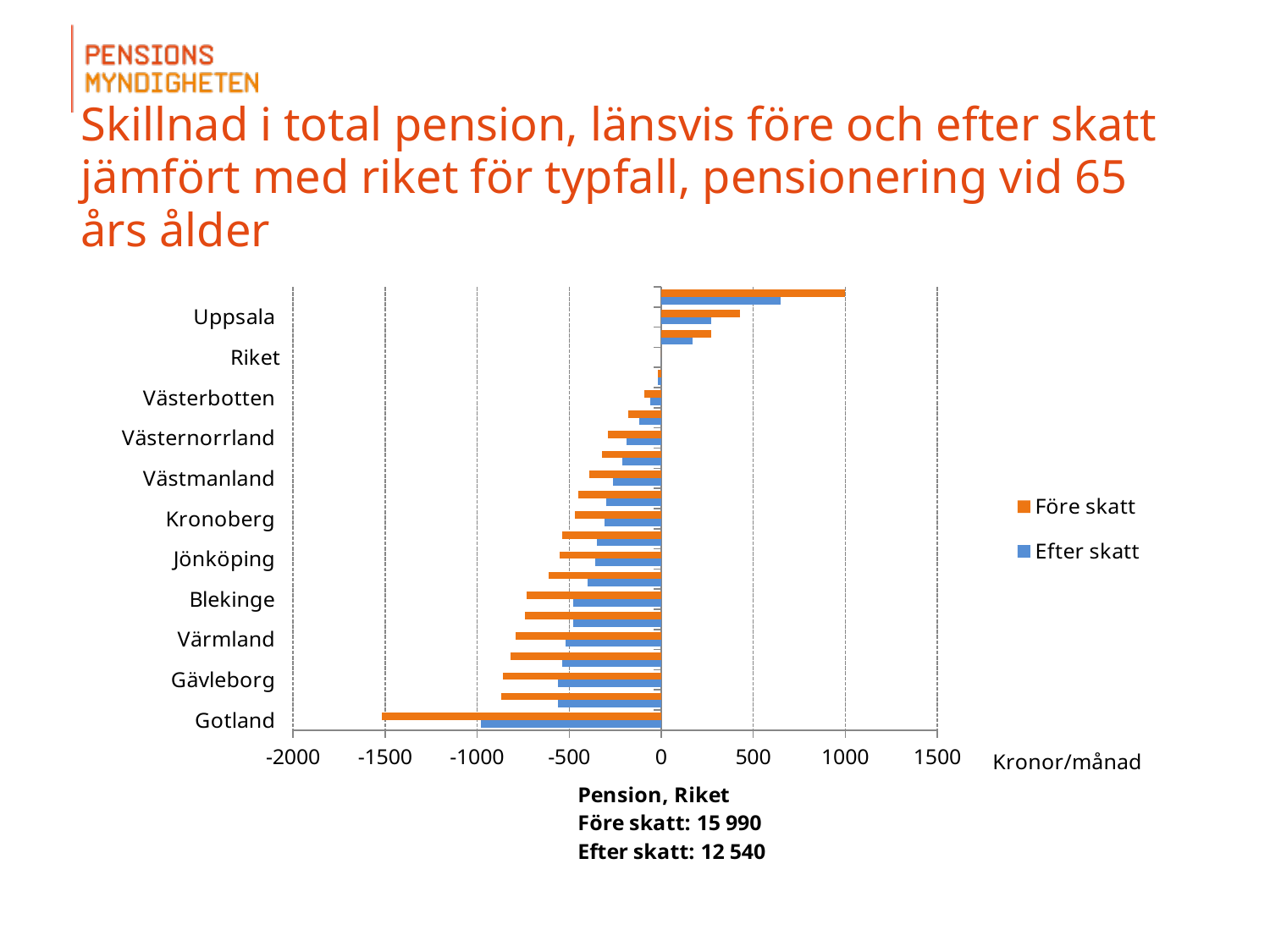
Is the Före skatt value for Gotland greater or less than -1000? less Is the Före skatt value for Uppsala greater or less than 0? greater Is the Före skatt value for Gävleborg greater or less than -500? less How many series does the chart legend list? 2 Which has the larger Före skatt value, Gotland or Uppsala? Uppsala According to the text below the chart, what is the pension for Riket before tax (Före skatt)? 15 990 What unit label is shown next to the x axis of the chart? Kronor/månad What are the two series named in the chart legend? Före skatt and Efter skatt Which labelled county has the lowest Före skatt value? Gotland What kind of chart is shown on the slide? bar chart For Gävleborg, which series has the larger (less negative) value, Före skatt or Efter skatt? Efter skatt